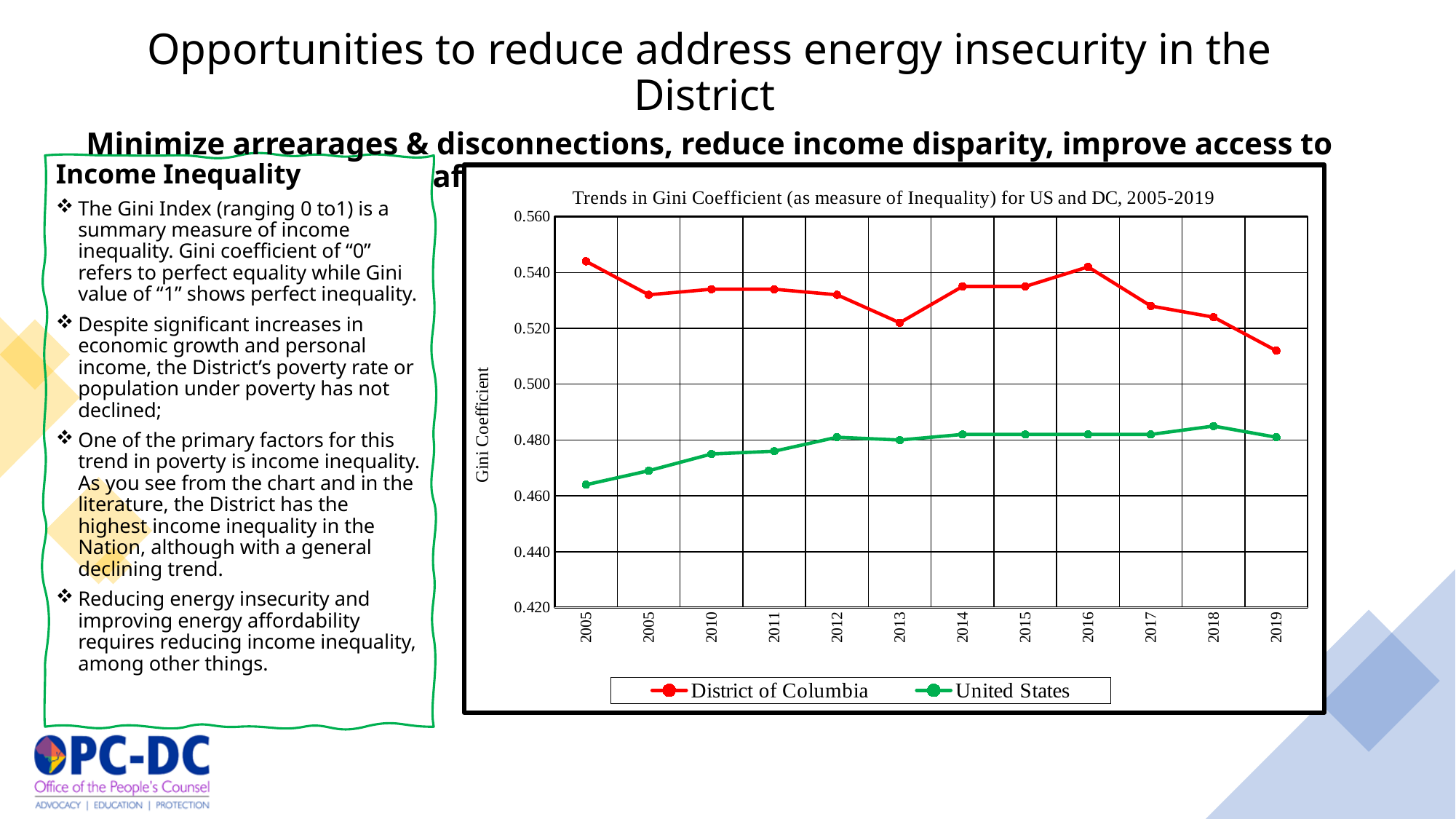
In which year is the United States Gini coefficient lowest? 2005 Does the United States Gini coefficient generally rise or fall from 2005 to 2019? rise What kind of chart is shown on the slide? line chart In which year is the District of Columbia Gini coefficient lowest? 2019 Is the United States value for 2010 greater or less than 0.480? less How many series does the legend list? 2 Is the District of Columbia value for the first 2005 point greater or less than 0.540? greater In 2019, which series has the larger Gini coefficient, District of Columbia or United States? District of Columbia How many data points are plotted for each series along the x axis? 12 In which year is the United States Gini coefficient highest? 2018 What is the label on the y axis of the chart? Gini Coefficient Is the District of Columbia value for 2019 greater or less than 0.520? less